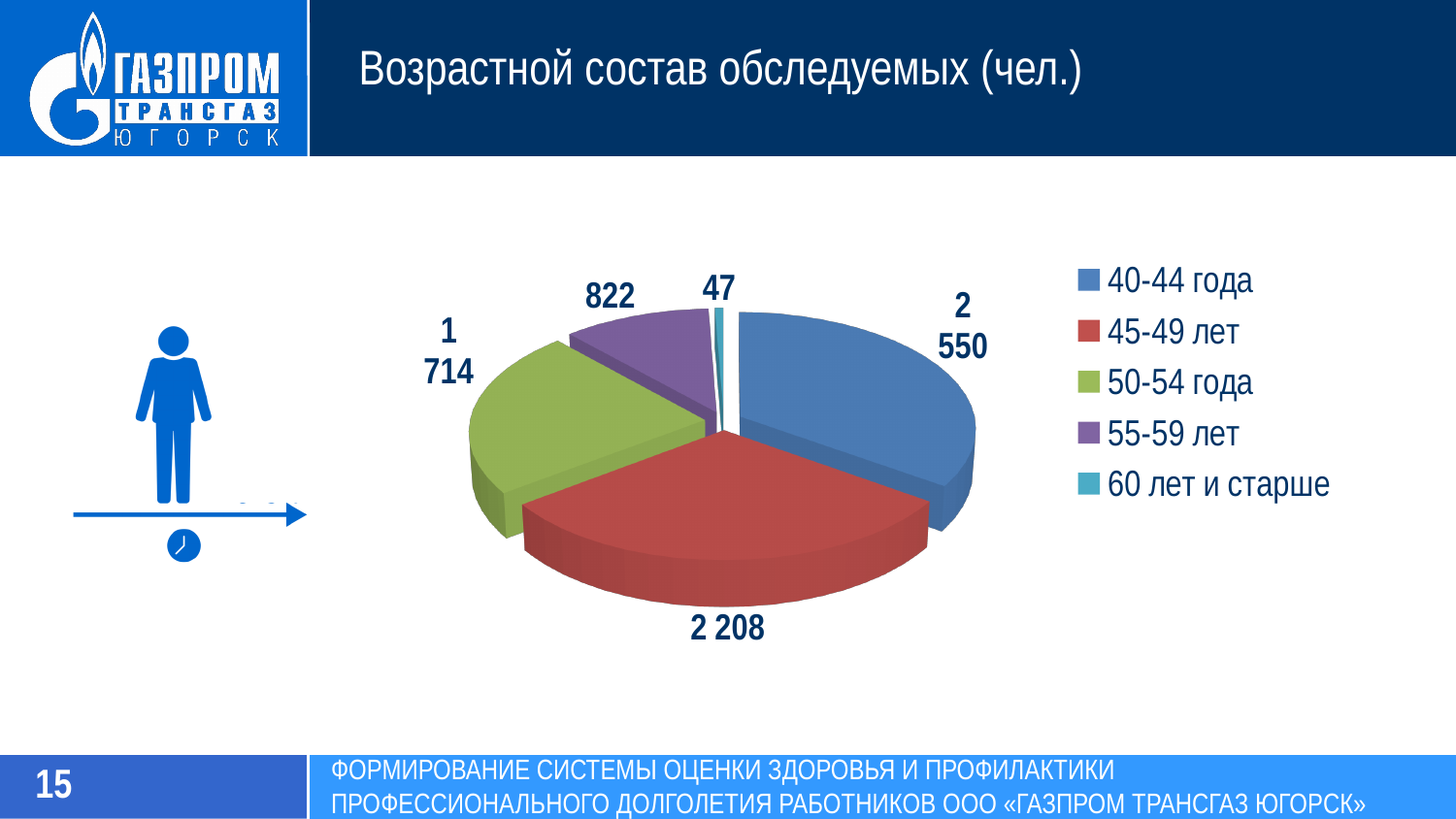
What is the value for the 45-49 лет category? 2 208 How many categories does the pie chart have? 5 Which age category has the highest value? 40-44 года What is the value for the 50-54 года category? 1 714 Which age category has the lowest value? 60 лет и старше What is the value for the 40-44 года category? 2 550 What is the difference between the values for 40-44 года and 45-49 лет? 342 What is the title of the chart? Возрастной состав обследуемых (чел.) Which is larger, the value for 50-54 года or the value for 55-59 лет? 50-54 года What kind of chart is shown on the slide? pie chart What is the value for the 55-59 лет category? 822 What is the value for the 60 лет и старше category? 47